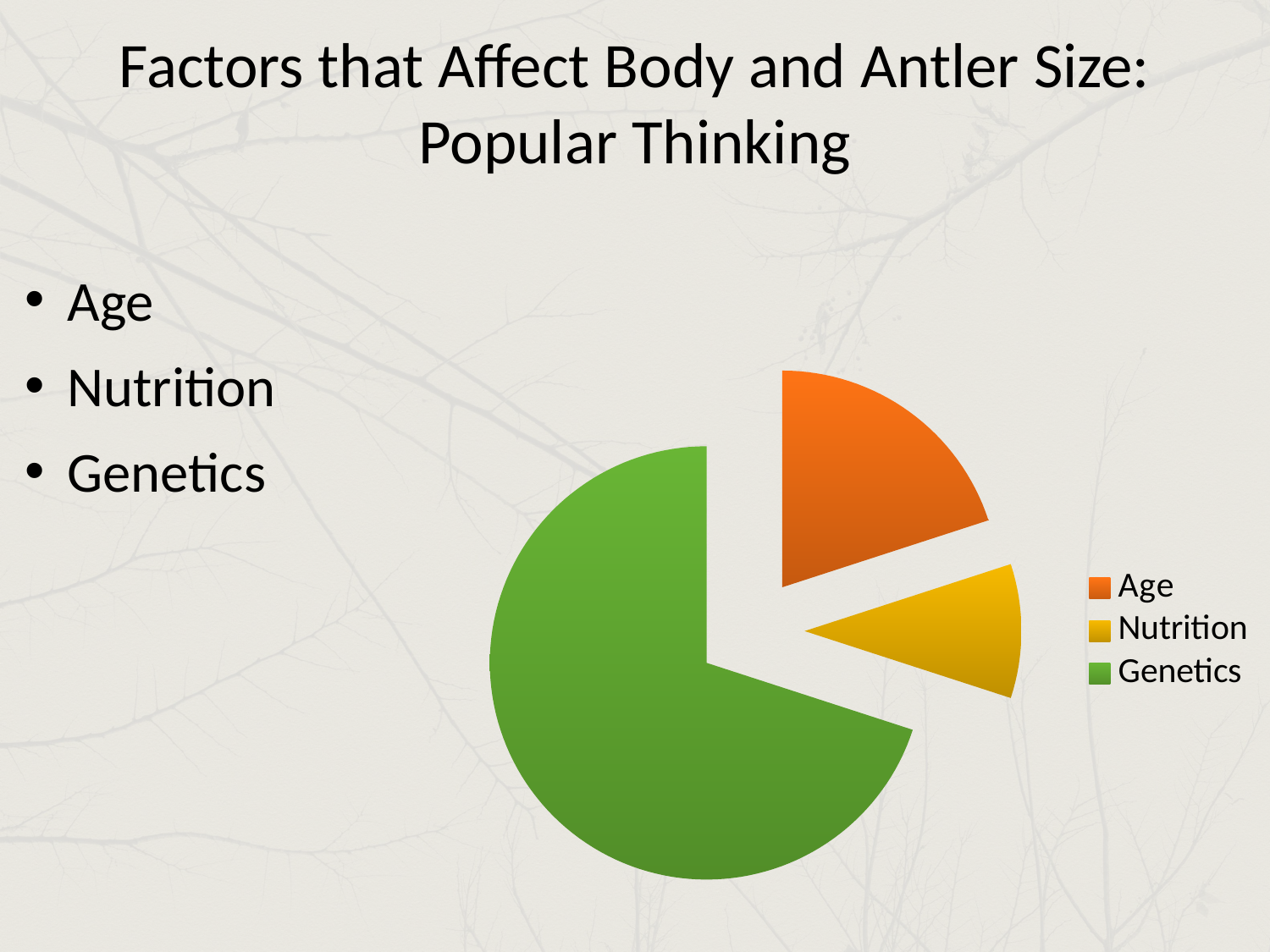
Which slice is larger in the pie chart, Age or Nutrition? Age Which category is shown in orange in the pie chart? Age Which category has the smallest slice of the pie chart? Nutrition What colour is the Genetics slice in the pie chart? green How many slices does the pie chart have? 3 Which category has the largest slice of the pie chart? Genetics How many entries does the pie chart's legend list? 3 What kind of chart is shown on the slide? pie chart Which slice is larger in the pie chart, Genetics or Age? Genetics Which slice is larger in the pie chart, Genetics or Nutrition? Genetics